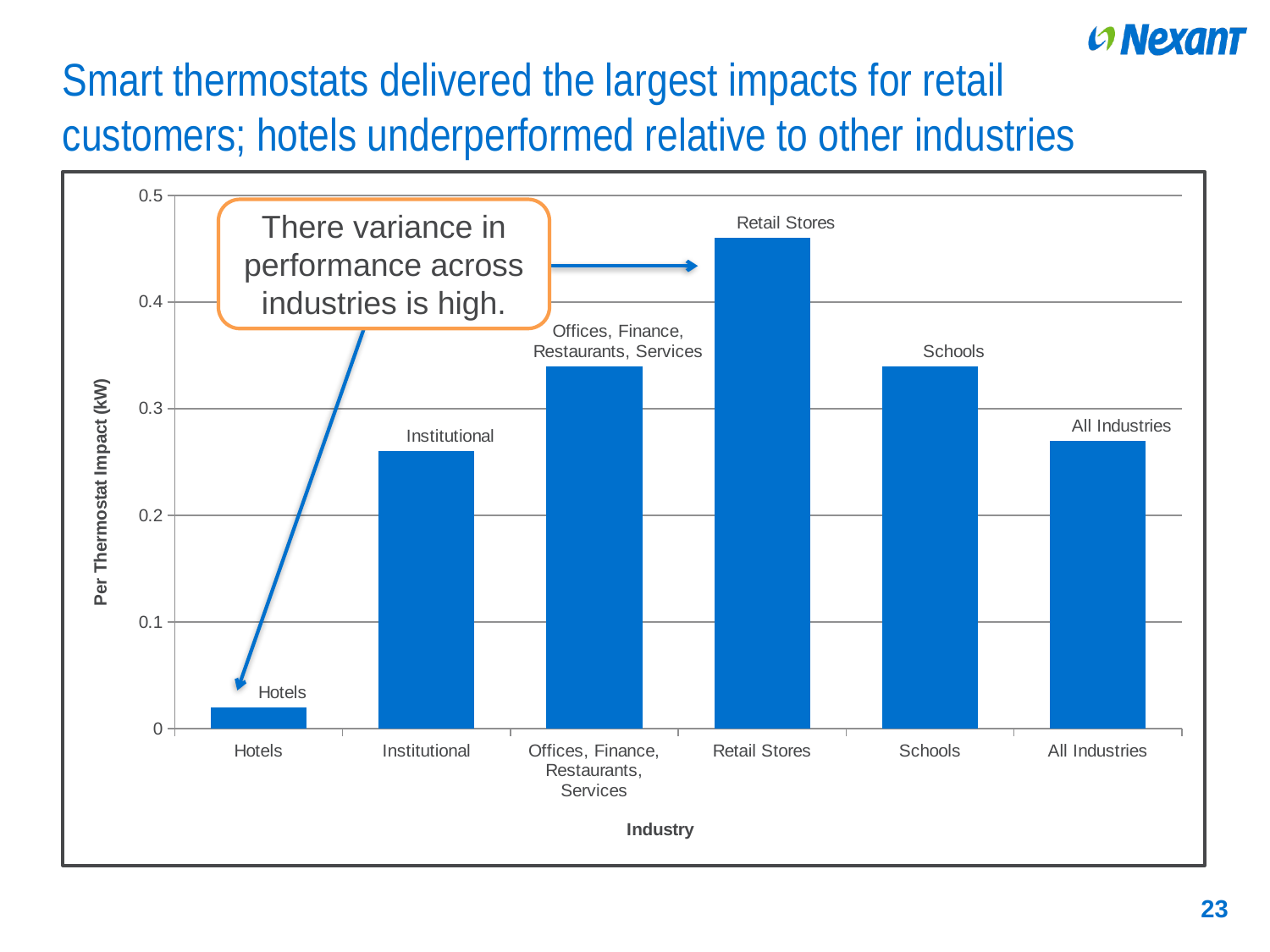
Is the value for Hotels greater or less than 0.1? less Which industry has the lowest per thermostat impact? Hotels Which has a larger per thermostat impact, Hotels or Institutional? Institutional What kind of chart is shown on the slide? bar chart Is the value for All Industries greater or less than 0.3? less What is the label of the y axis? Per Thermostat Impact (kW) Which has a larger per thermostat impact, Retail Stores or Schools? Retail Stores Is the value for Institutional greater or less than 0.2? greater How many industry categories are plotted on the chart? 6 Which industry has the highest per thermostat impact? Retail Stores